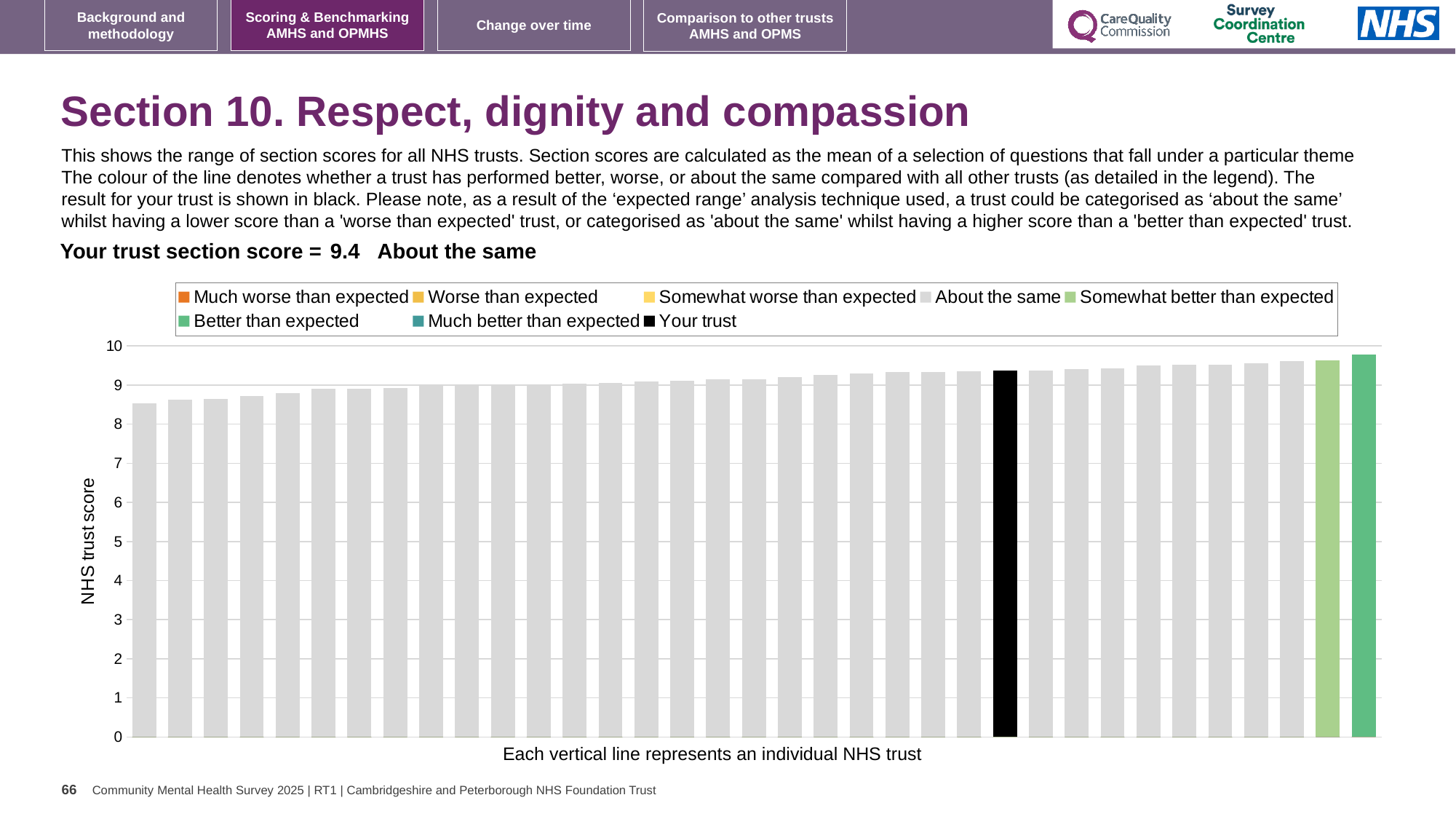
Which bar is the shortest in the chart? the leftmost bar What is the label on the vertical axis of the chart? NHS trust score Which bar is the tallest in the chart? the rightmost (green) bar Do the bar values rise or fall from left to right across the chart? rise Which performance category is your trust placed in for this section? About the same Is the value for the black 'Your trust' bar greater or less than 9? greater Is the value for the rightmost bar greater or less than 9? greater How many entries does the chart legend list? 8 What type of chart is shown on the slide? bar chart What is the section score for your trust shown on the slide? 9.4 Is the value for the leftmost bar greater or less than 9? less Which is taller: the black 'Your trust' bar or the leftmost bar? the black 'Your trust' bar